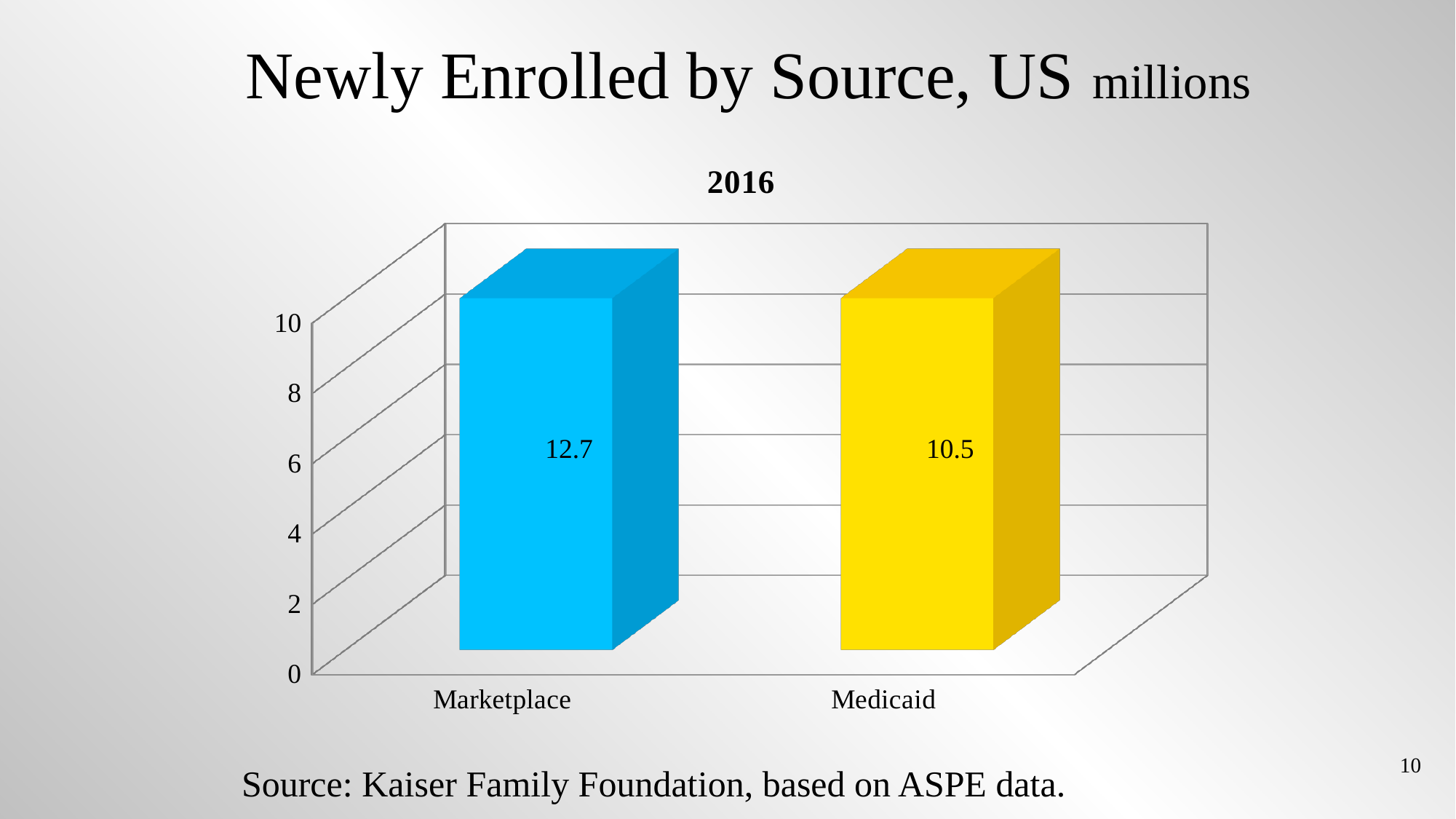
How many categories are shown on the x axis? 2 Which category has the lowest value? Medicaid Is the value for Medicaid greater or less than 8? greater What is the value for Marketplace? 12.7 What colour is the Medicaid bar? yellow Which is larger, the value for Marketplace or the value for Medicaid? Marketplace Which category has the highest value? Marketplace What is the value for Medicaid? 10.5 What is the title of the chart? 2016 What is the difference between the Marketplace and Medicaid values? 2.2 What kind of chart is shown on the slide? bar chart